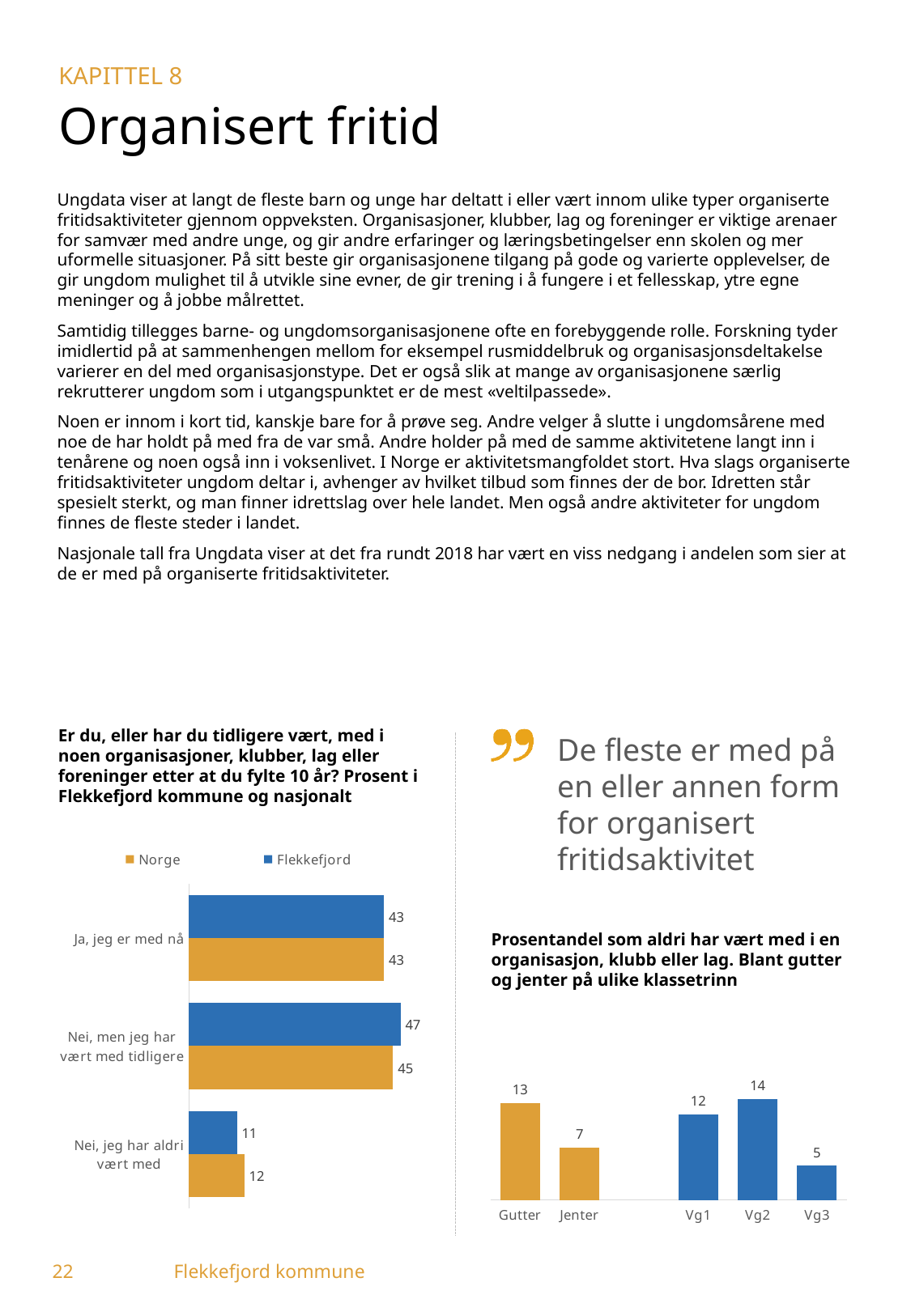
In the left chart ("Er du, eller har du tidligere vært, med i noen organisasjoner..."), what is the value for Flekkefjord for "Nei, men jeg har vært med tidligere"? 47 In the right chart ("Prosentandel som aldri har vært med i en organisasjon..."), how many categories are shown? 5 In the right chart ("Prosentandel som aldri har vært med i en organisasjon..."), what is the value for Jenter? 7 In the left chart ("Er du, eller har du tidligere vært, med i noen organisasjoner..."), which category has the lowest value for Flekkefjord? Nei, jeg har aldri vært med In the left chart ("Er du, eller har du tidligere vært, med i noen organisasjoner..."), which colour represents Norge? Orange In the left chart ("Er du, eller har du tidligere vært, med i noen organisasjoner..."), what is the difference between Flekkefjord and Norge for "Nei, men jeg har vært med tidligere"? 2 In the right chart ("Prosentandel som aldri har vært med i en organisasjon..."), which category has the lowest value? Vg3 In the left chart ("Er du, eller har du tidligere vært, med i noen organisasjoner..."), what is the value for Norge for "Nei, jeg har aldri vært med"? 12 In the left chart ("Er du, eller har du tidligere vært, med i noen organisasjoner..."), how many series does the legend list? 2 In the right chart ("Prosentandel som aldri har vært med i en organisasjon..."), which category has the highest value? Vg2 In the right chart ("Prosentandel som aldri har vært med i en organisasjon..."), what is the difference between Gutter and Jenter? 6 In the left chart ("Er du, eller har du tidligere vært, med i noen organisasjoner..."), what kind of chart is it? Bar chart